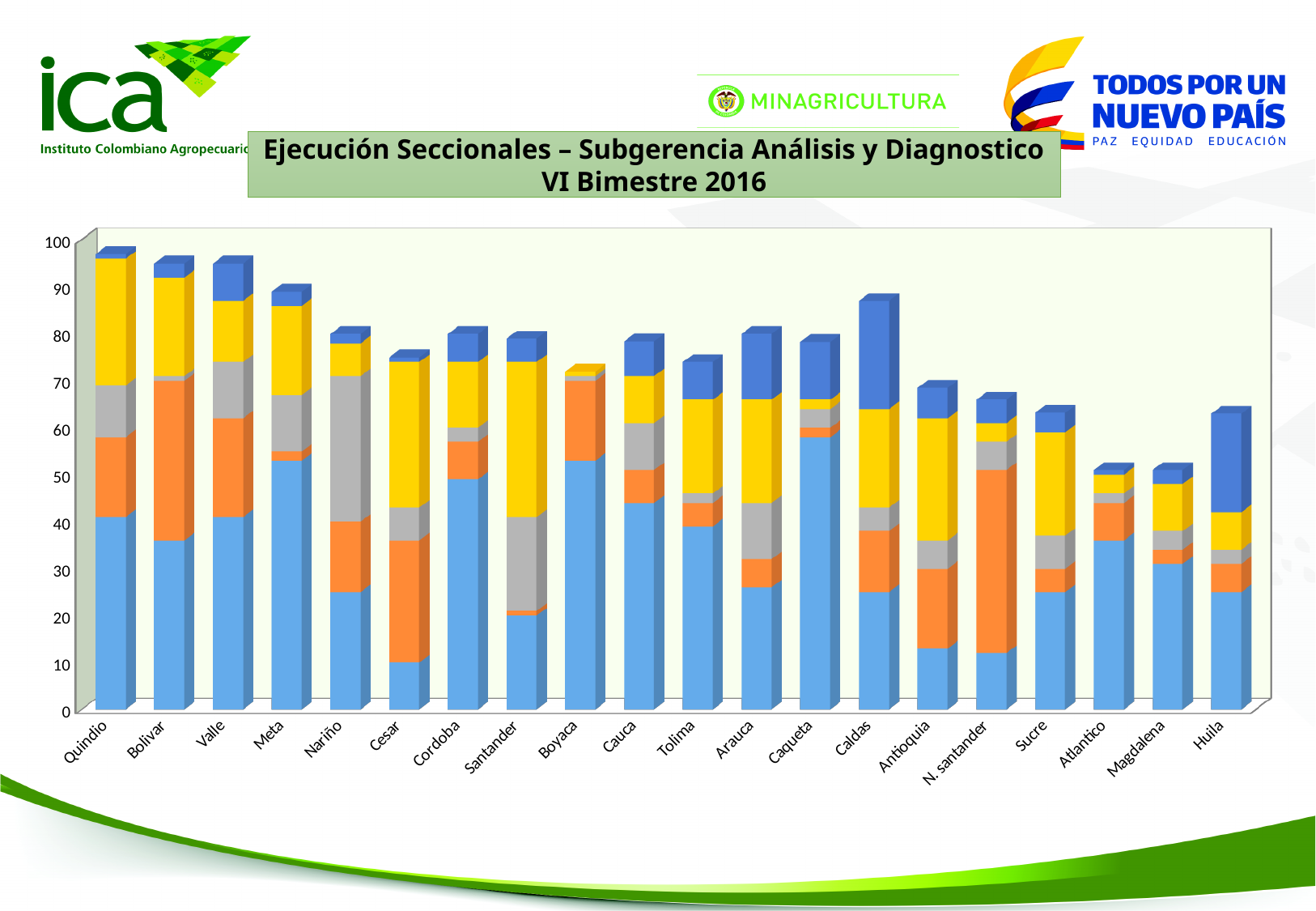
Which has the larger total stacked value, Quindio or Magdalena? Quindio Is the total stacked value for Sucre greater or less than 70? less Which has the larger total stacked value, Caldas or Huila? Caldas What is the title of the chart on the slide? Ejecución Seccionales – Subgerencia Análisis y Diagnostico VI Bimestre 2016 Is the total stacked value for Caldas greater or less than 80? greater What is the maximum value shown on the vertical axis of the chart? 100 Is the total stacked value for Huila greater or less than 70? less What kind of chart is shown on the slide? Stacked bar chart How many categories (seccionales) are shown on the x axis of the chart? 20